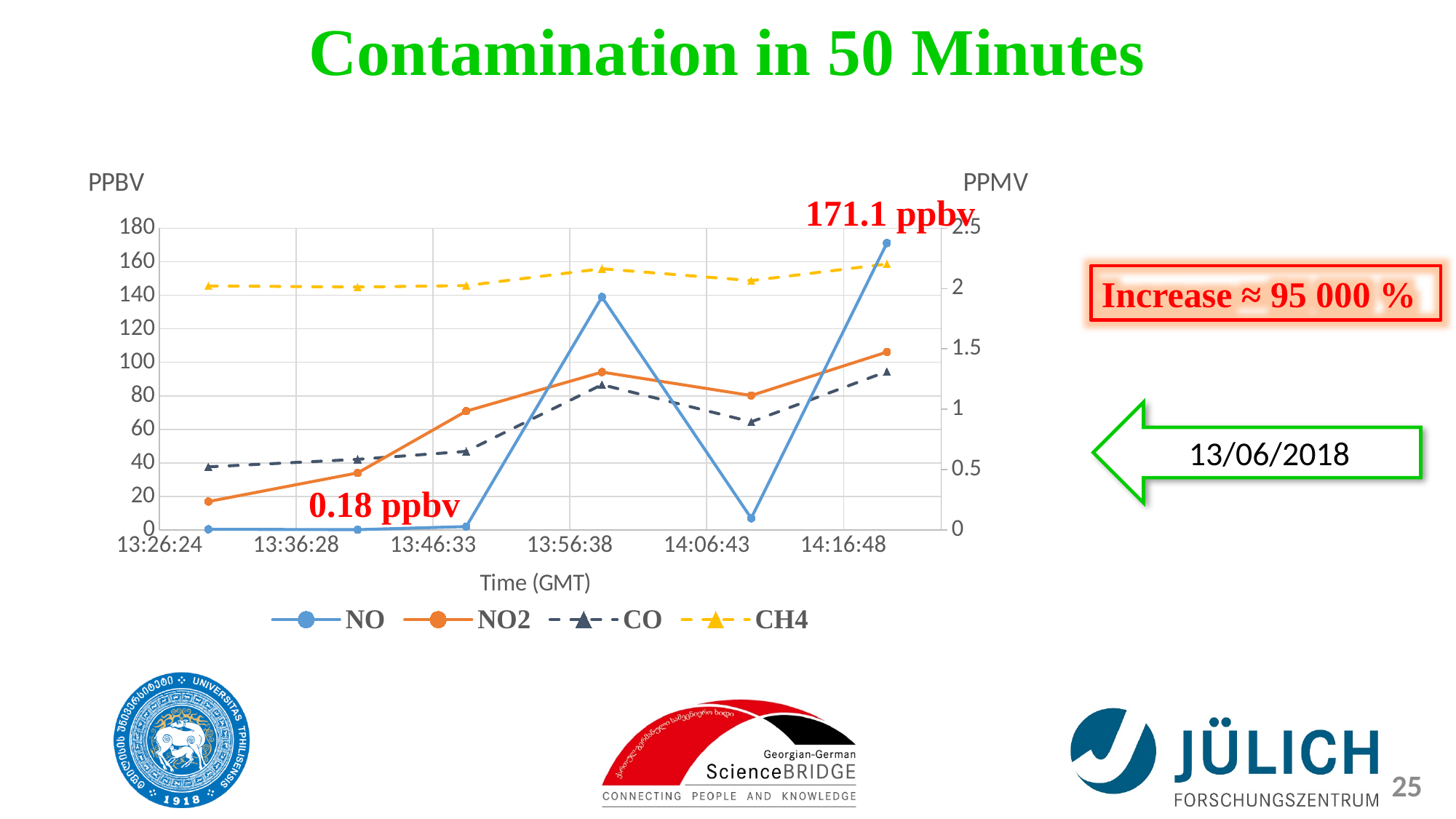
At the last time point, which is higher, NO or NO2? NO What is the lowest NO value labelled on the chart? 0.18 ppbv What unit label is shown above the left vertical axis? PPBV How many series does the chart legend list? 4 Is the NO value at the 13:56:38 peak greater or less than 120 on the PPBV axis? greater What is the title of the x axis? Time (GMT) Does the NO2 series rise or fall from the first time point to the last? rise What is the difference between the two labelled NO values, 171.1 ppbv and 0.18 ppbv? 170.92 ppbv What is the highest NO value labelled on the chart? 171.1 ppbv Is the NO2 value at the last time point greater or less than 100 on the PPBV axis? greater What kind of chart is shown on the slide? line chart How many data points are plotted for the NO series? 6